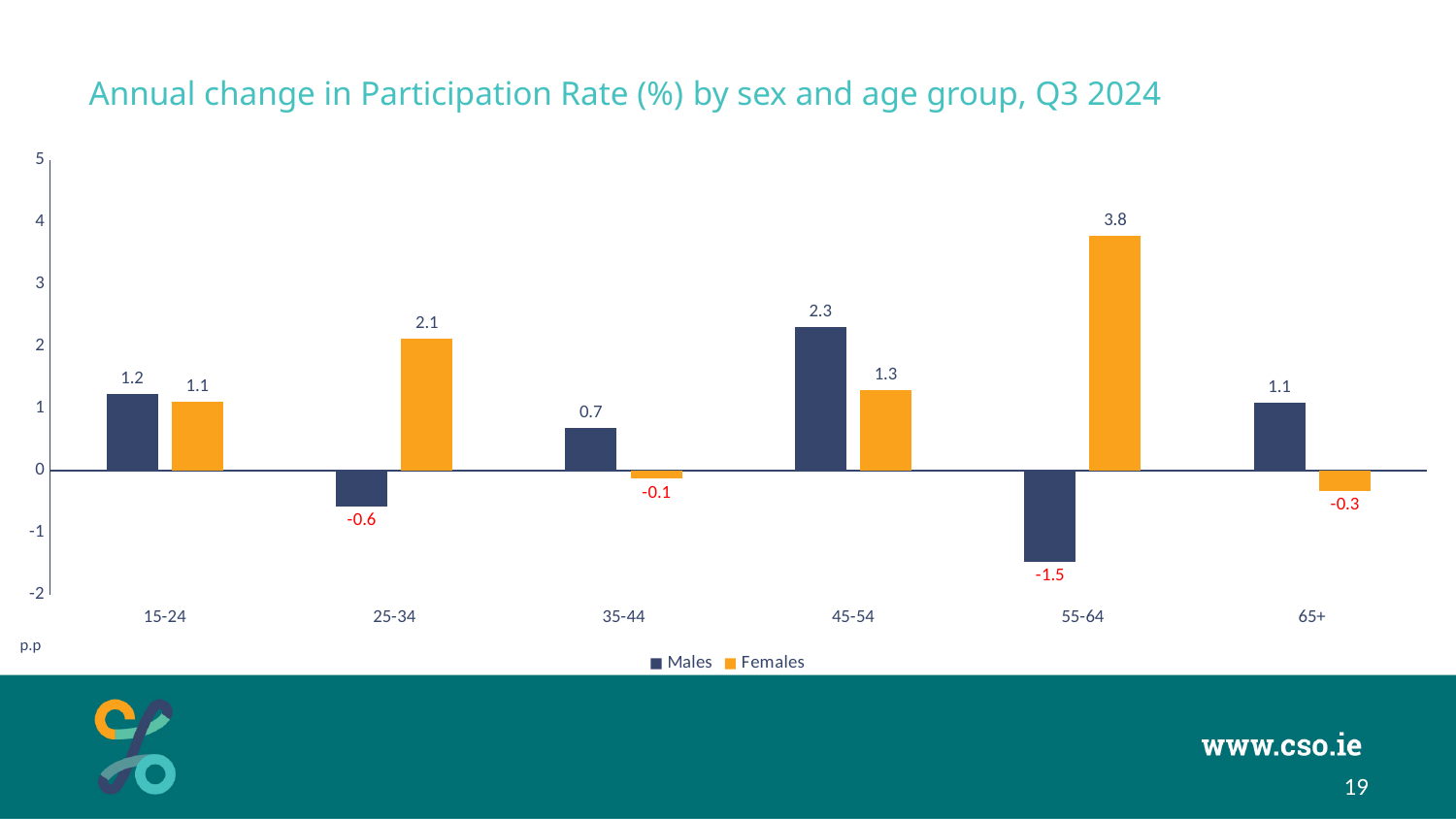
What is the difference between the Females and Males values in the 55-64 age group? 5.3 What is the value for Males in the 55-64 age group? -1.5 What is the title of the chart? Annual change in Participation Rate (%) by sex and age group, Q3 2024 Which is larger in the 25-34 age group, the Males value or the Females value? Females What kind of chart is shown on the slide? Bar chart How many series does the legend list? 2 What is the value for Females in the 65+ age group? -0.3 Which age group has the lowest value for Males? 55-64 How many age groups are shown on the x axis? 6 What is the value for Males in the 45-54 age group? 2.3 Which age group has the highest value for Females? 55-64 What is the value for Females in the 55-64 age group? 3.8